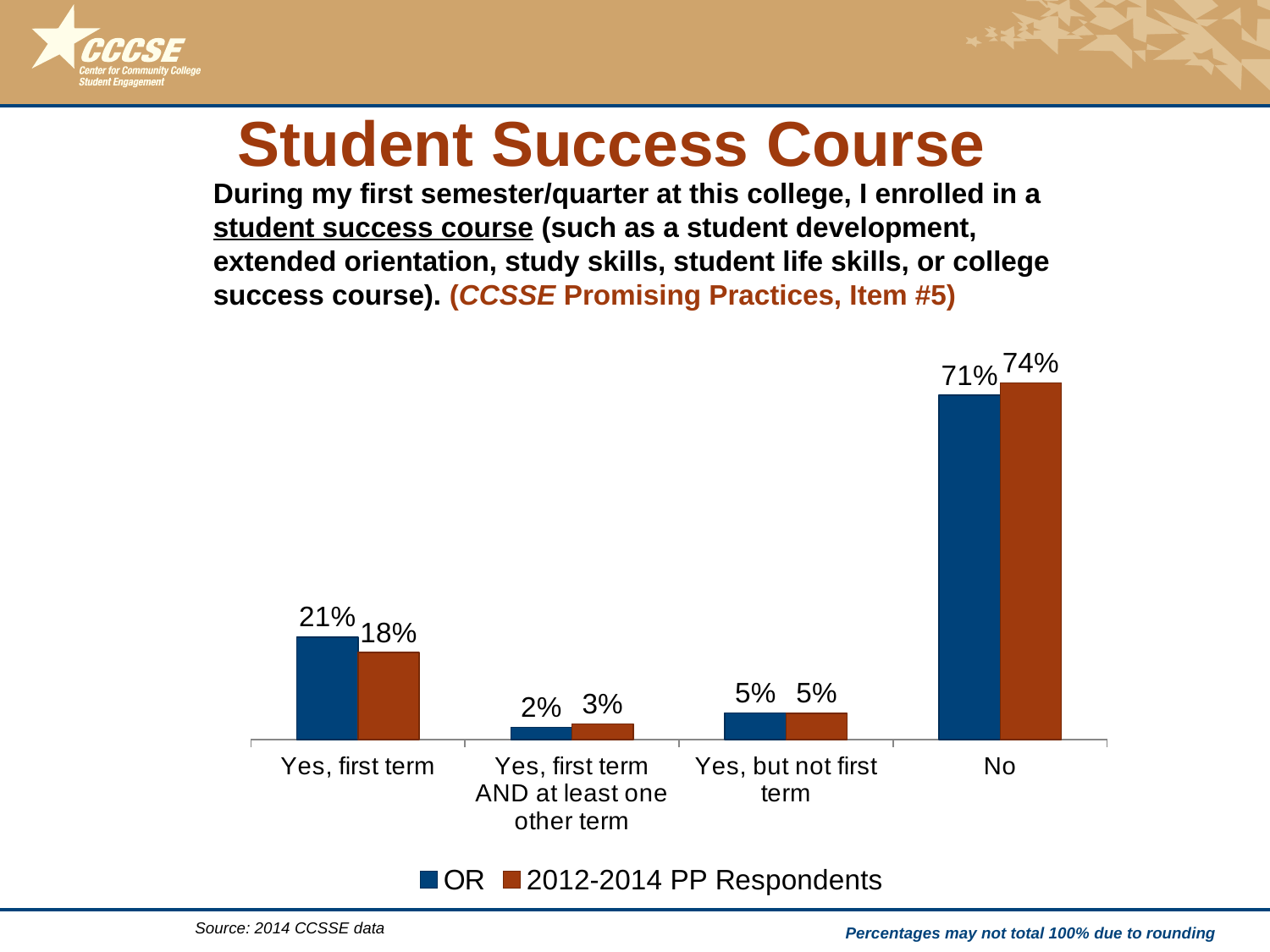
Which category has the highest value for OR? No What is the difference between the OR value and the 2012-2014 PP Respondents value in the 'Yes, first term' category? 3% How many categories are shown on the x axis? 4 What is the value for 2012-2014 PP Respondents in the 'Yes, first term AND at least one other term' category? 3% How many series does the legend list? 2 What is the value for 2012-2014 PP Respondents in the 'No' category? 74% What is the value for OR in the 'Yes, first term' category? 21% What kind of chart is shown on the slide? Bar chart What is the difference between the 2012-2014 PP Respondents value and the OR value in the 'No' category? 3% Which category has the lowest value for 2012-2014 PP Respondents? Yes, first term AND at least one other term What is the value for OR in the 'Yes, but not first term' category? 5% In the 'Yes, first term' category, which series has the larger value, OR or 2012-2014 PP Respondents? OR